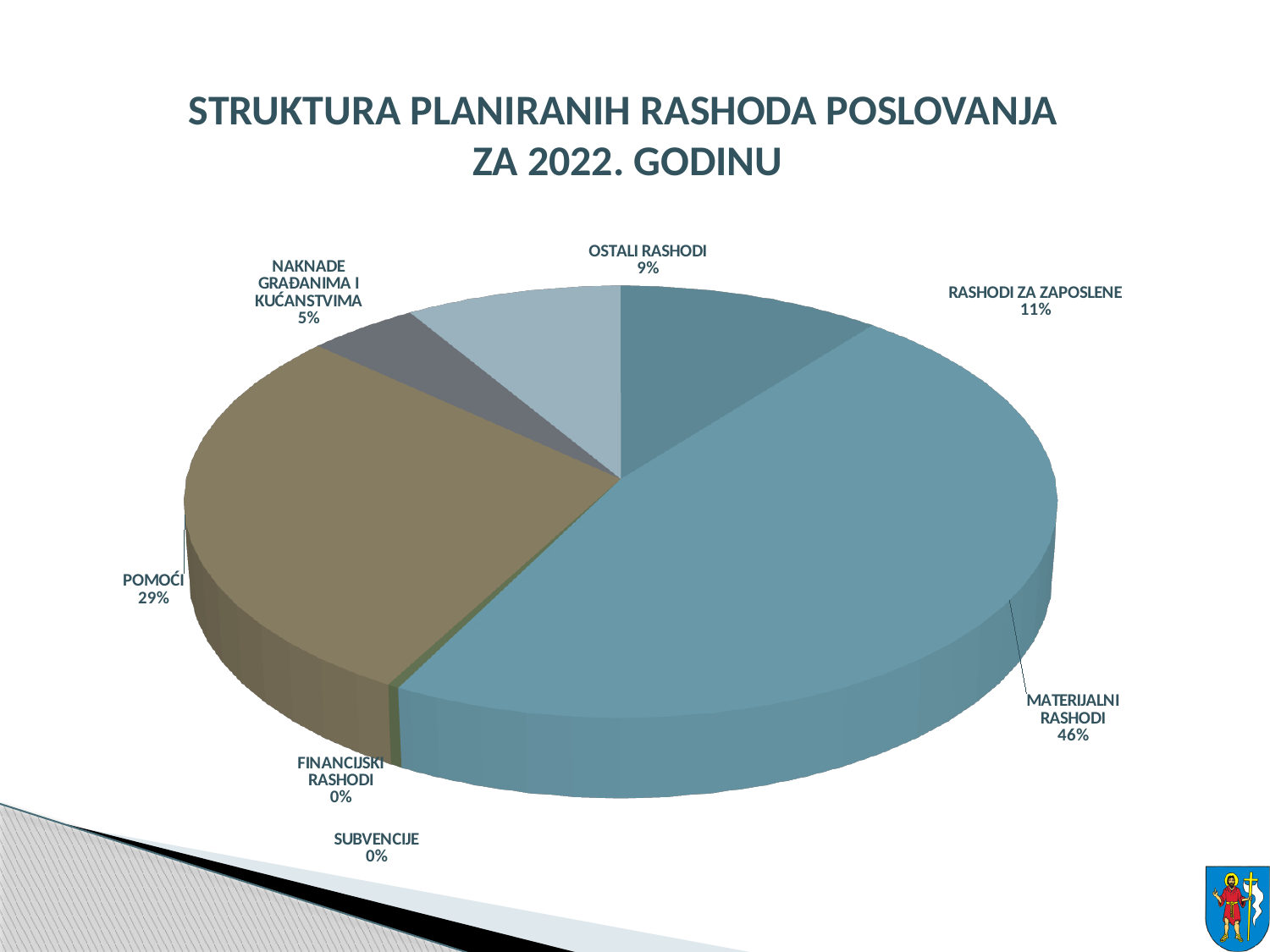
What percentage is shown for NAKNADE GRAĐANIMA I KUĆANSTVIMA? 5% What type of chart is shown on the slide? Pie chart What share of the pie is MATERIJALNI RASHODI? 46% What is the title of the chart? STRUKTURA PLANIRANIH RASHODA POSLOVANJA ZA 2022. GODINU What percentage is shown for OSTALI RASHODI? 9% Which is larger, RASHODI ZA ZAPOSLENE or OSTALI RASHODI? RASHODI ZA ZAPOSLENE What is the difference in percentage points between MATERIJALNI RASHODI and POMOĆI? 17 Which two categories are shown with 0%? FINANCIJSKI RASHODI and SUBVENCIJE What percentage is shown for POMOĆI? 29% What percentage is shown for RASHODI ZA ZAPOSLENE? 11% How many categories (slices) are labelled in the pie chart? 7 Which category has the largest share of the pie? MATERIJALNI RASHODI